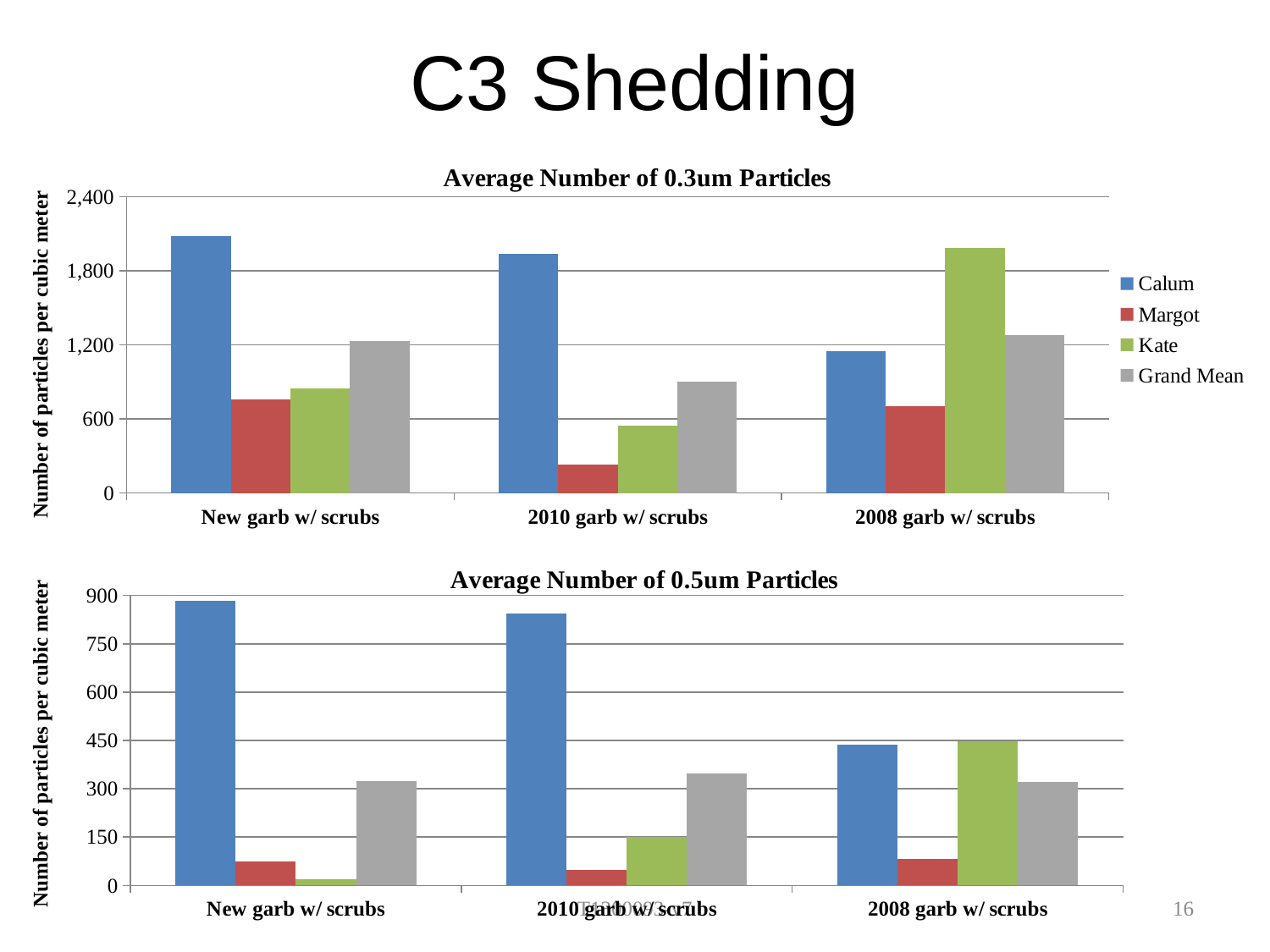
How many categories are shown on the x axis of the 'Average Number of 0.5um Particles' chart? 3 In the 'Average Number of 0.5um Particles' chart, which series has the lowest value for New garb w/ scrubs? Kate In the 'Average Number of 0.5um Particles' chart, is the value for Calum at New garb w/ scrubs greater or less than 750? greater In the 'Average Number of 0.3um Particles' chart, which series has the highest value for 2008 garb w/ scrubs? Kate How many series does the legend of the 'Average Number of 0.3um Particles' chart list? 4 In the 'Average Number of 0.3um Particles' chart, which series has the highest value for New garb w/ scrubs? Calum In the 'Average Number of 0.3um Particles' chart, is the value for Calum at New garb w/ scrubs greater or less than 1,800? greater In the 'Average Number of 0.3um Particles' chart, is the value for Margot at 2010 garb w/ scrubs greater or less than 600? less What is the y-axis title of the 'Average Number of 0.5um Particles' chart? Number of particles per cubic meter What kind of chart is the 'Average Number of 0.3um Particles' chart? bar chart In the 'Average Number of 0.3um Particles' chart, is Calum's value larger for New garb w/ scrubs or for 2008 garb w/ scrubs? New garb w/ scrubs